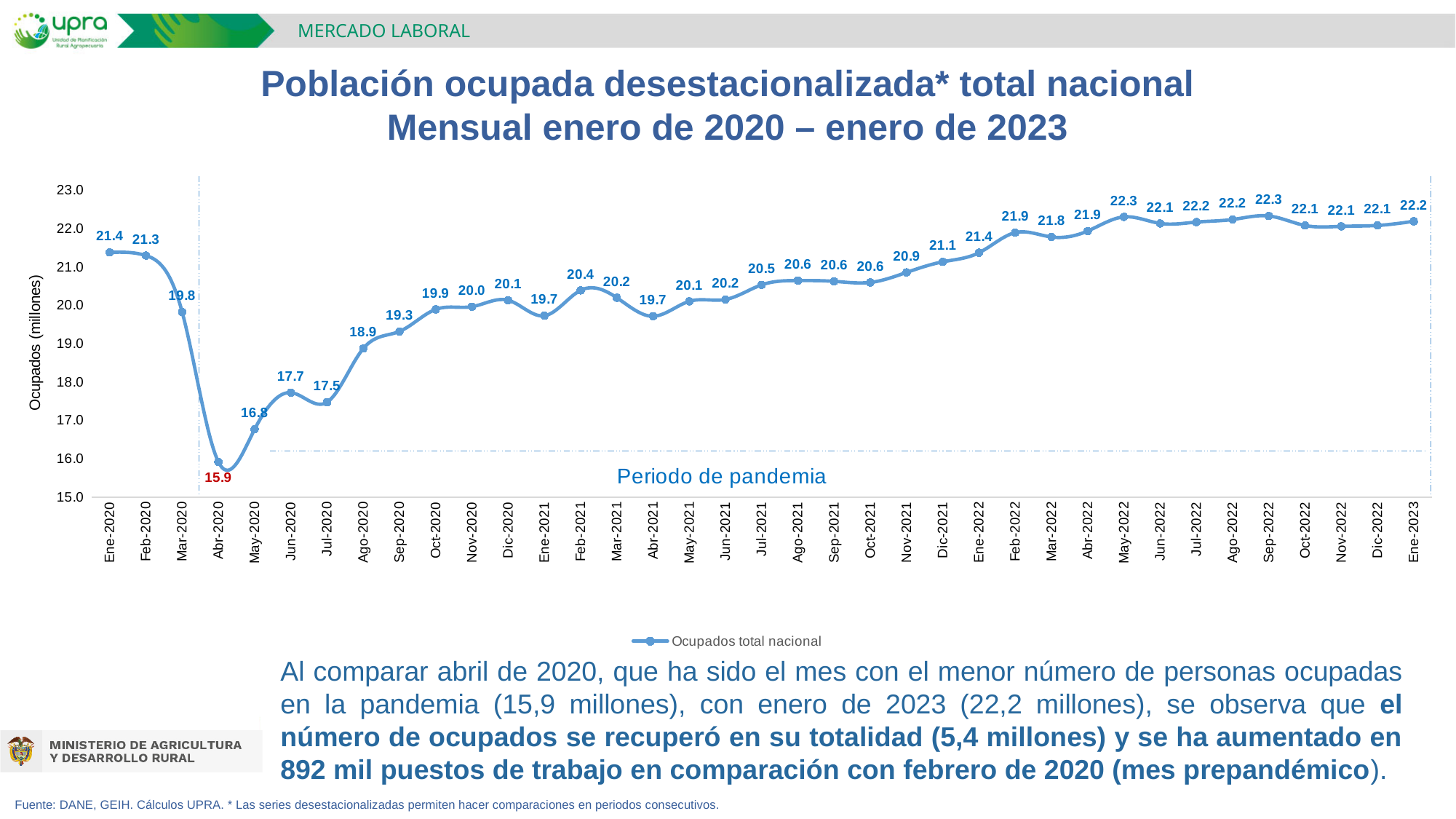
What is the value for Ene-2023? 22.2 Which month has the lowest value? Abr-2020 What is the label of the y axis? Ocupados (millones) What is the difference between the values for Ene-2023 and Abr-2020? 6.3 What is the difference between the values for Ene-2020 and Mar-2020? 1.6 What kind of chart is shown? Line chart What is the value for Abr-2020? 15.9 Which is larger, the value for Feb-2021 or the value for Abr-2021? Feb-2021 How many data points are plotted on the chart? 37 Which is larger, the value for Jun-2020 or the value for Jul-2020? Jun-2020 How many series does the legend list? 1 What is the value for Feb-2020? 21.3